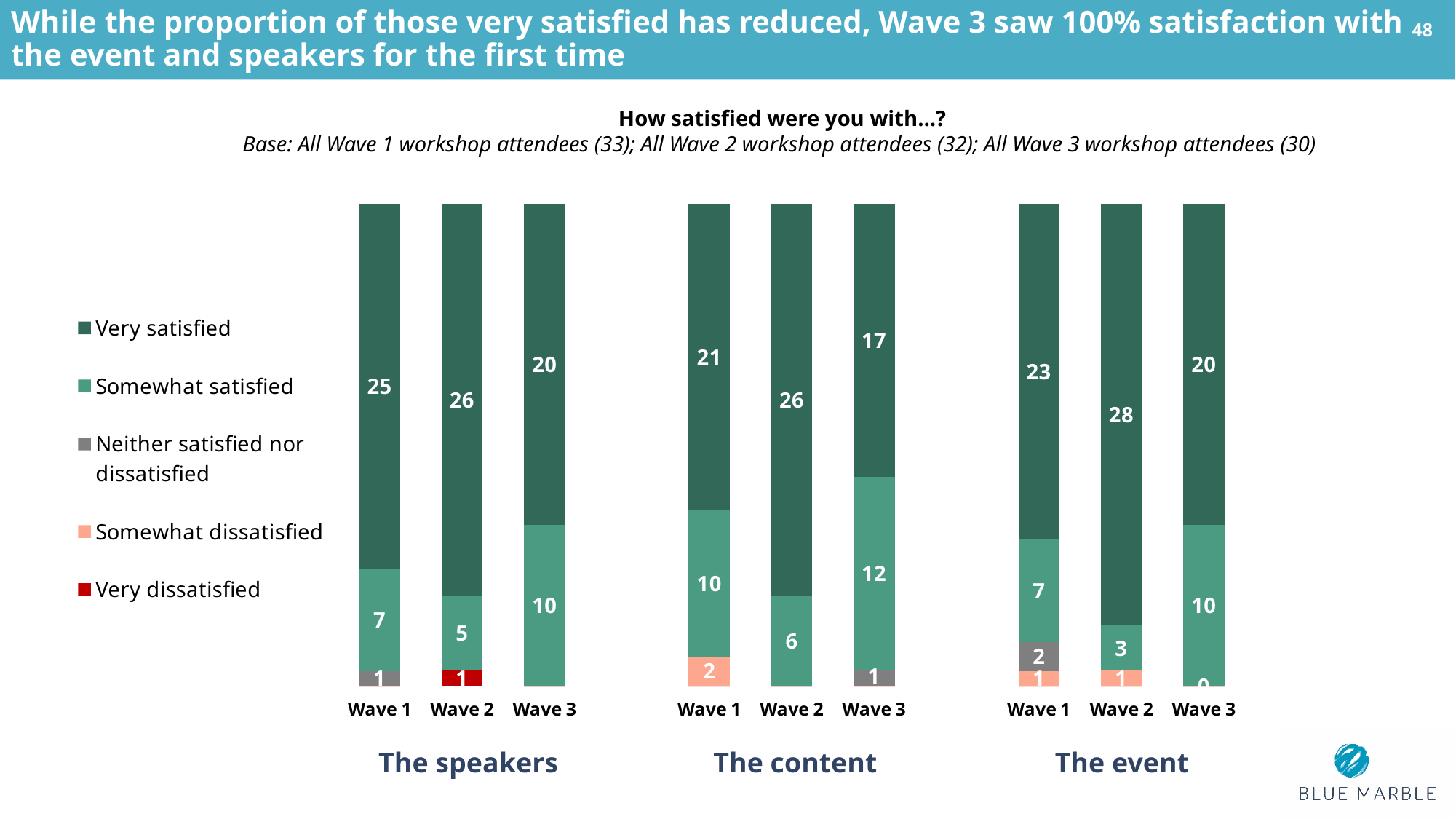
In the chart titled 'The speakers', what is the difference between the Very satisfied values for Wave 2 and Wave 3? 6 How many series does the legend list? 5 In the chart titled 'The speakers', what is the total of the stacked bar for Wave 1? 33 In the chart titled 'The content', which wave has the lowest Very satisfied value? Wave 3 In the chart titled 'The speakers', what is the Very satisfied value for Wave 2? 26 In the chart titled 'The event', what is the Very satisfied value for Wave 2? 28 In the chart titled 'The event', which is larger: the Somewhat satisfied value for Wave 1 or for Wave 3? Wave 3 In the chart titled 'The event', which wave has the highest Very satisfied value? Wave 2 What kind of chart is used on this slide? Stacked bar chart In the chart titled 'The content', what is the total of the stacked bar for Wave 2? 32 In the chart titled 'The content', what is the Somewhat dissatisfied value for Wave 1? 2 In the chart titled 'The content', what is the Somewhat satisfied value for Wave 3? 12